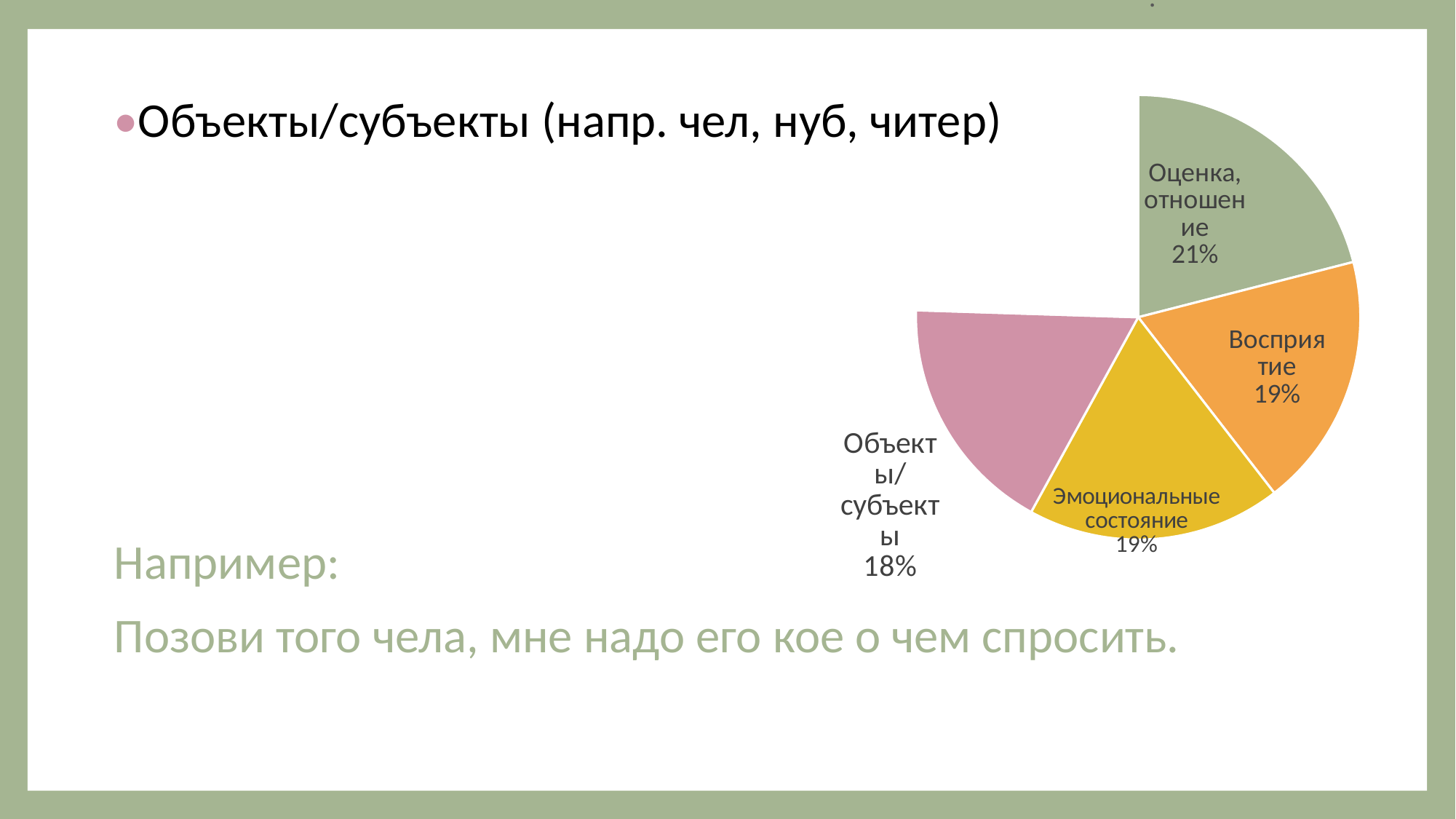
What kind of chart is shown on the slide? pie chart What share of the pie does the slice "Оценка, отношение" have? 21% Which slice is larger, "Восприятие" or "Объекты/субъекты"? Восприятие What is the difference in percentage points between the "Оценка, отношение" slice and the "Объекты/субъекты" slice? 3 What colour is the "Оценка, отношение" slice of the pie? green What colour is the "Объекты/субъекты" slice of the pie? pink What share of the pie does the slice "Объекты/субъекты" have? 18% What is the difference in percentage points between the "Оценка, отношение" slice and the "Восприятие" slice? 2 What share of the pie does the slice "Эмоциональные состояние" have? 19% What is the difference in percentage points between the "Восприятие" slice and the "Объекты/субъекты" slice? 1 What share of the pie does the slice "Восприятие" have? 19% Which slice is larger, "Оценка, отношение" or "Объекты/субъекты"? Оценка, отношение